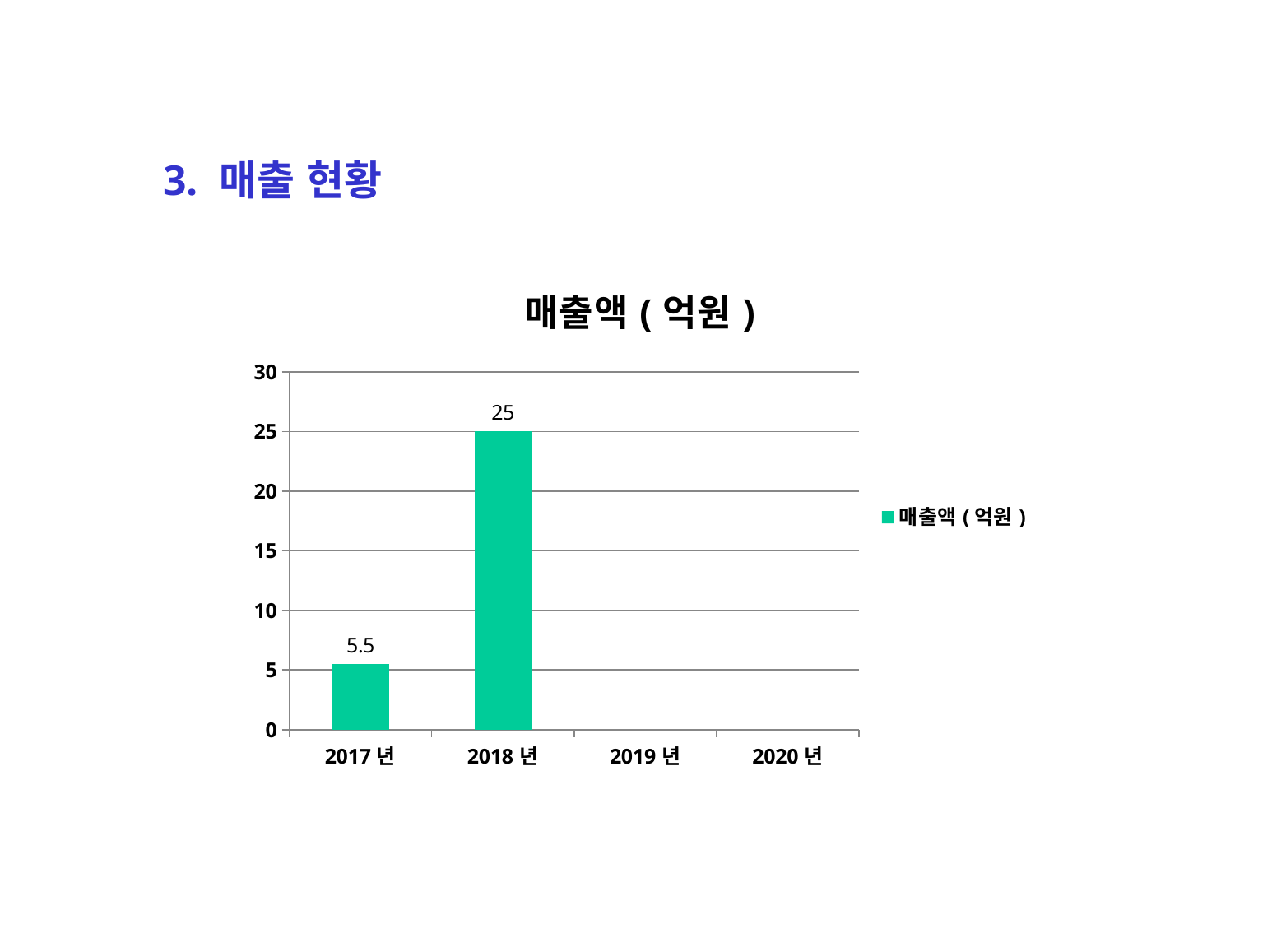
What is the value for 2017 년? 5.5 Is the value for 2017 년 greater or less than 10? less What is the difference between the values for 2018 년 and 2017 년? 19.5 Which is larger, the value for 2017 년 or 2018 년? 2018 년 What kind of chart is shown? bar chart What is the value for 2018 년? 25 What is the title of the chart? 매출액 ( 억원 ) Which year has the highest value? 2018 년 Is the value for 2018 년 greater or less than 20? greater Does the value rise or fall from 2017 년 to 2018 년? rise How many series does the legend list? 1 How many categories are shown on the x axis? 4